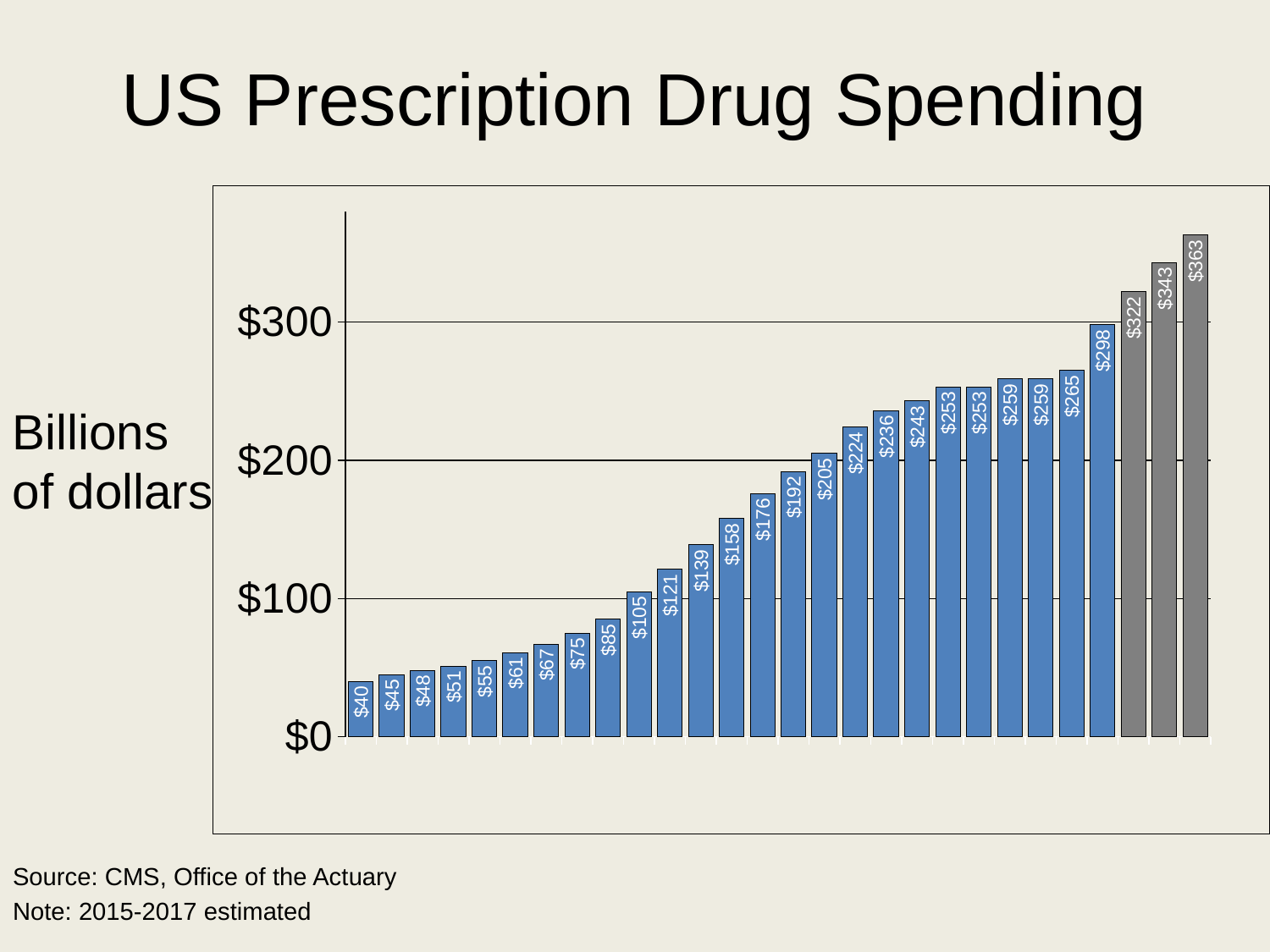
What is the difference between the tallest gray bar and the tallest blue bar? $65 What is the lowest value shown on the chart? $40 What is the value of the tallest blue bar? $298 What is the difference between the highest and lowest values on the chart? $323 Do the values rise or fall from left to right along the x axis? Rise What is the value of the first (leftmost) bar? $40 What kind of chart is shown on the slide? Bar chart How many bars are shaded gray rather than blue? 3 How many bars are plotted on the chart? 28 What unit is given for the values on the chart? Billions of dollars What is the title of the chart? US Prescription Drug Spending What is the highest value shown on the chart? $363